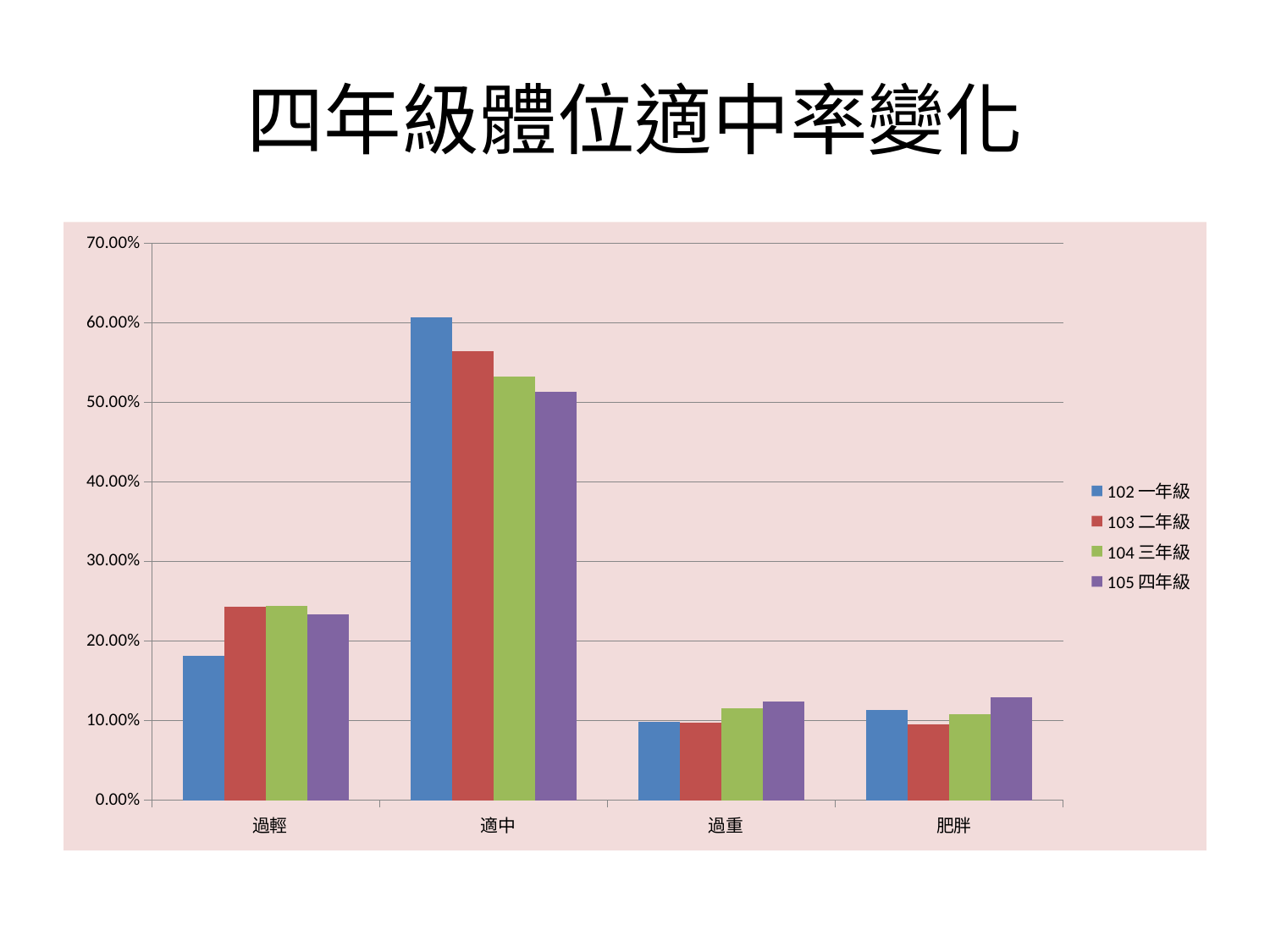
What kind of chart is shown on the slide? bar chart Is the value for 103 二年級 in the 過輕 category greater or less than 20.00%? greater Which category has the highest value for the 102 一年級 series? 適中 Do the values for 適中 rise or fall from 102 一年級 to 105 四年級? fall Is the value for 102 一年級 in the 過輕 category greater or less than 20.00%? less How many series does the legend list? 4 In the 適中 category, which is larger: the value for 102 一年級 or 105 四年級? 102 一年級 How many categories are shown on the x axis of the chart? 4 In the 過重 category, which is larger: the value for 102 一年級 or 105 四年級? 105 四年級 What is the title of the slide? 四年級體位適中率變化 In the 肥胖 category, which series has the lowest value? 103 二年級 Is the value for 102 一年級 in the 適中 category greater or less than 50.00%? greater